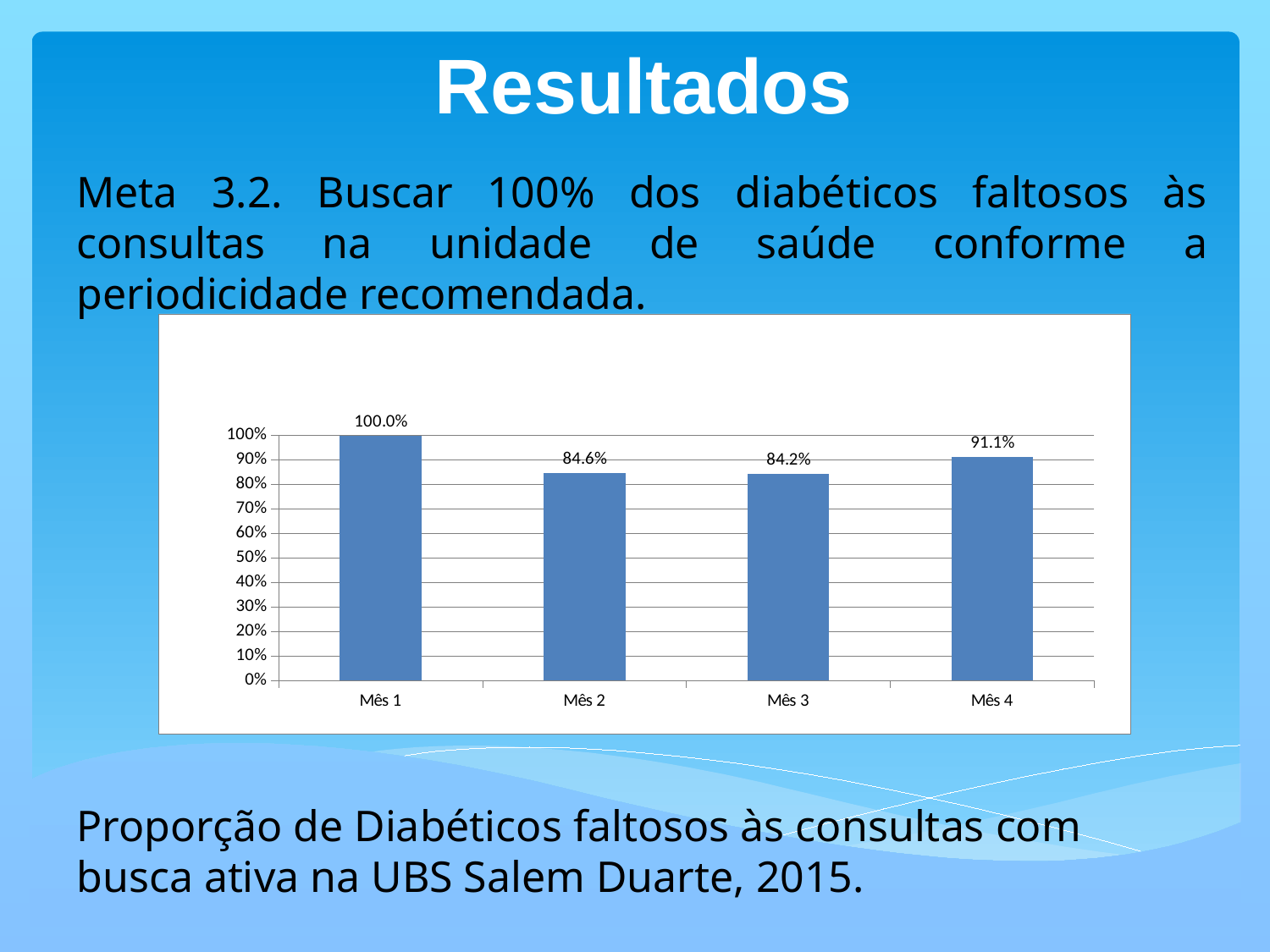
How many months are shown on the x axis? 4 Which is larger, the value for Mês 4 or the value for Mês 2? Mês 4 What is the value for Mês 2? 84.6% What is the difference between the values for Mês 1 and Mês 4? 8.9% Which month has the lowest value? Mês 3 What is the value for Mês 1? 100.0% What is the value for Mês 3? 84.2% What is the difference between the values for Mês 2 and Mês 3? 0.4% What is the value for Mês 4? 91.1% Is the value for Mês 4 greater or less than 90%? greater Which month has the highest value? Mês 1 What kind of chart is shown on the slide? Bar chart